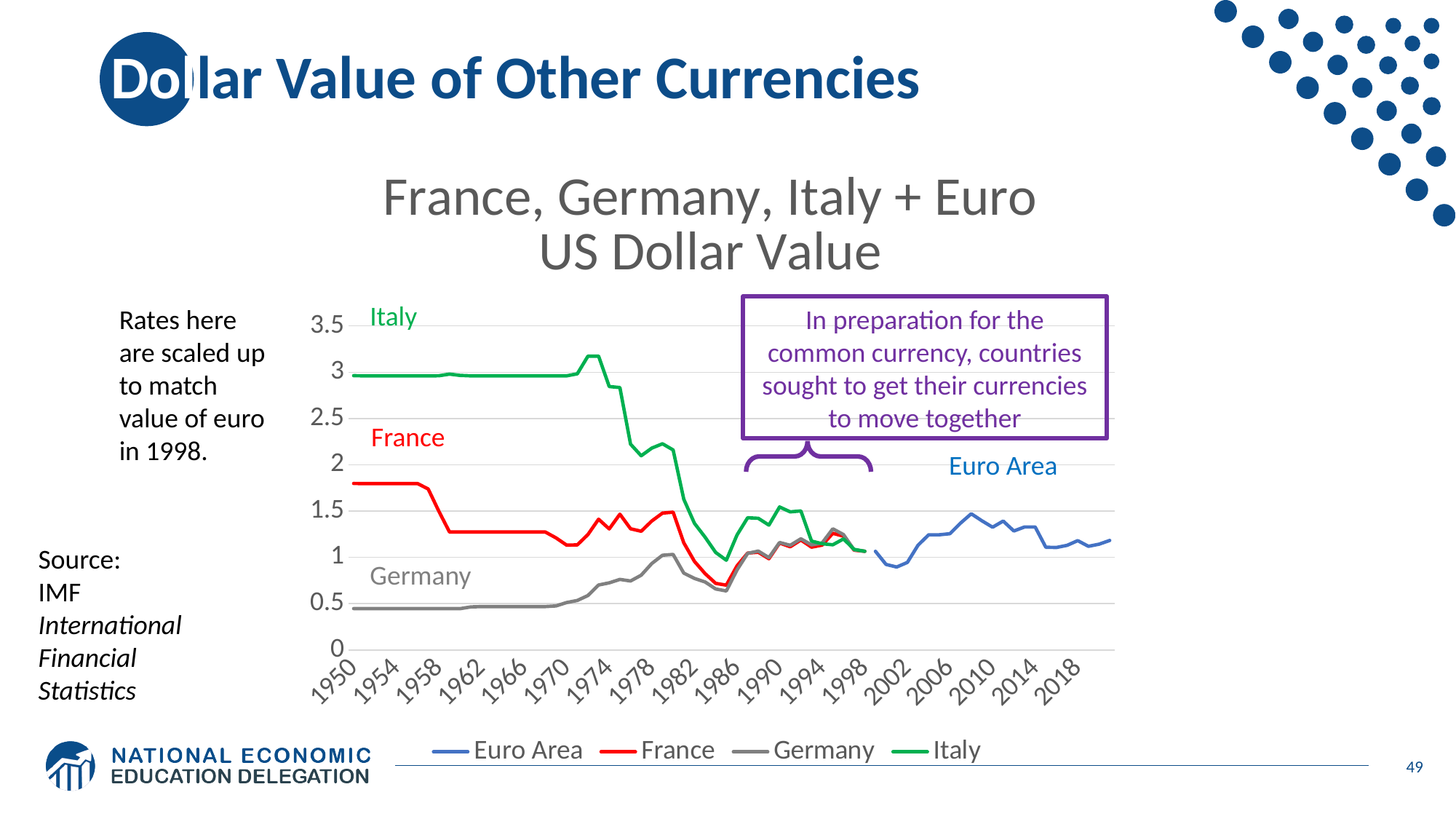
In 1950, which is higher, France or Germany? France What are the series listed in the chart legend? Euro Area, France, Germany, Italy Is the value for Germany in 1950 greater or less than 1? less What kind of chart is shown on the slide? line chart Is the value for France in 1950 greater or less than 1.5? greater Which series has the highest value in 1950? Italy Does the Italy line rise or fall between 1950 and 1986? fall Which series has the lowest value in 1950? Germany Is the value for Italy in 1950 greater or less than 2.5? greater What is the title of the chart? France, Germany, Italy + Euro US Dollar Value How many series does the chart legend list? 4